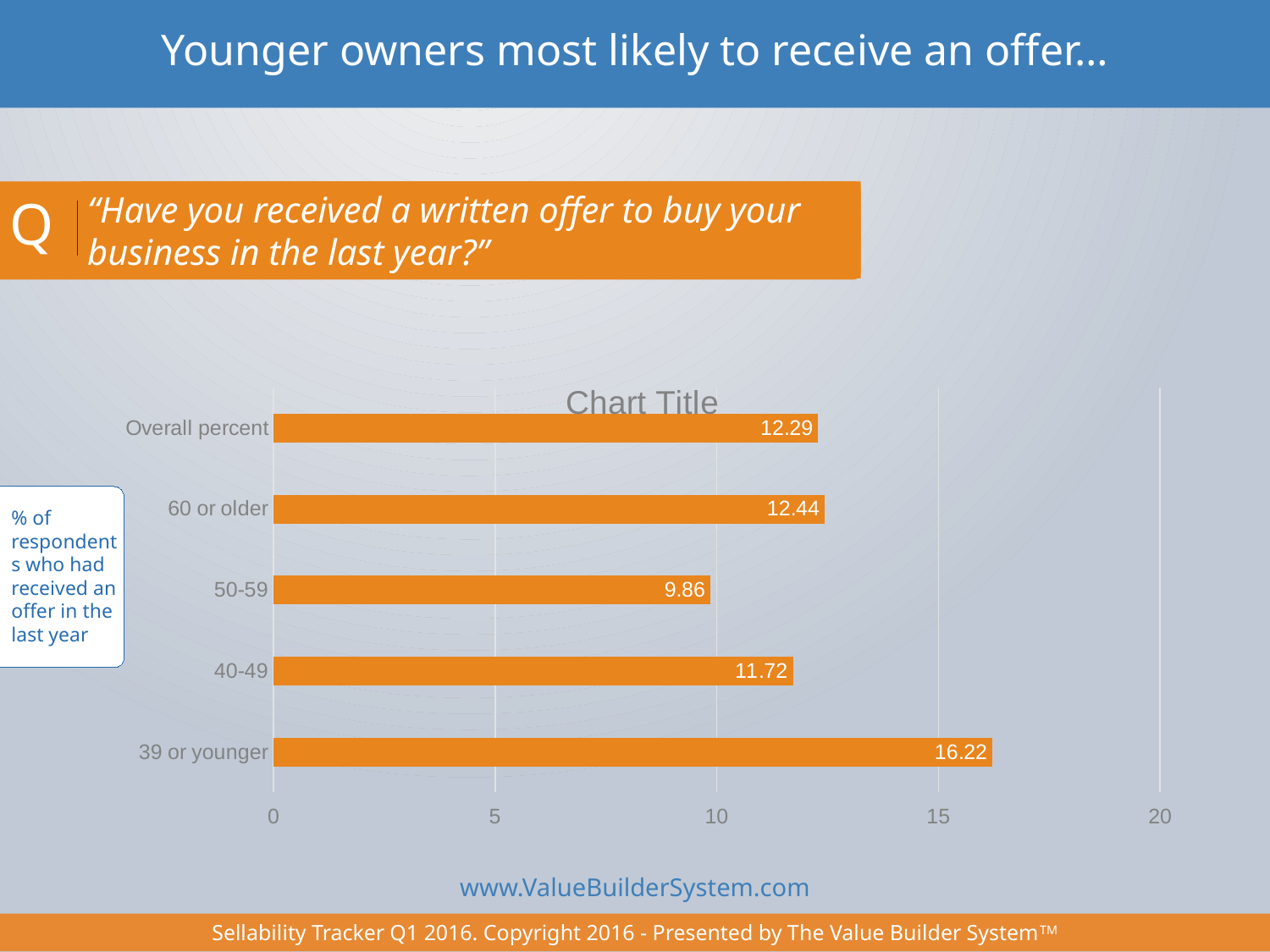
Which category has the lowest value? 50-59 What is the value for the 60 or older category? 12.44 Which category has the highest value? 39 or younger What is the value for the 50-59 category? 9.86 What is the value for the 39 or younger category? 16.22 What colour are the bars in the chart? orange What is the difference between the values for 39 or younger and 40-49? 4.5 How many categories are shown in the chart? 5 Which is larger, the value for 60 or older or the value for 50-59? 60 or older Is the value for 39 or younger greater or less than 15? greater What is the value for the Overall percent category? 12.29 What kind of chart is shown on the slide? bar chart